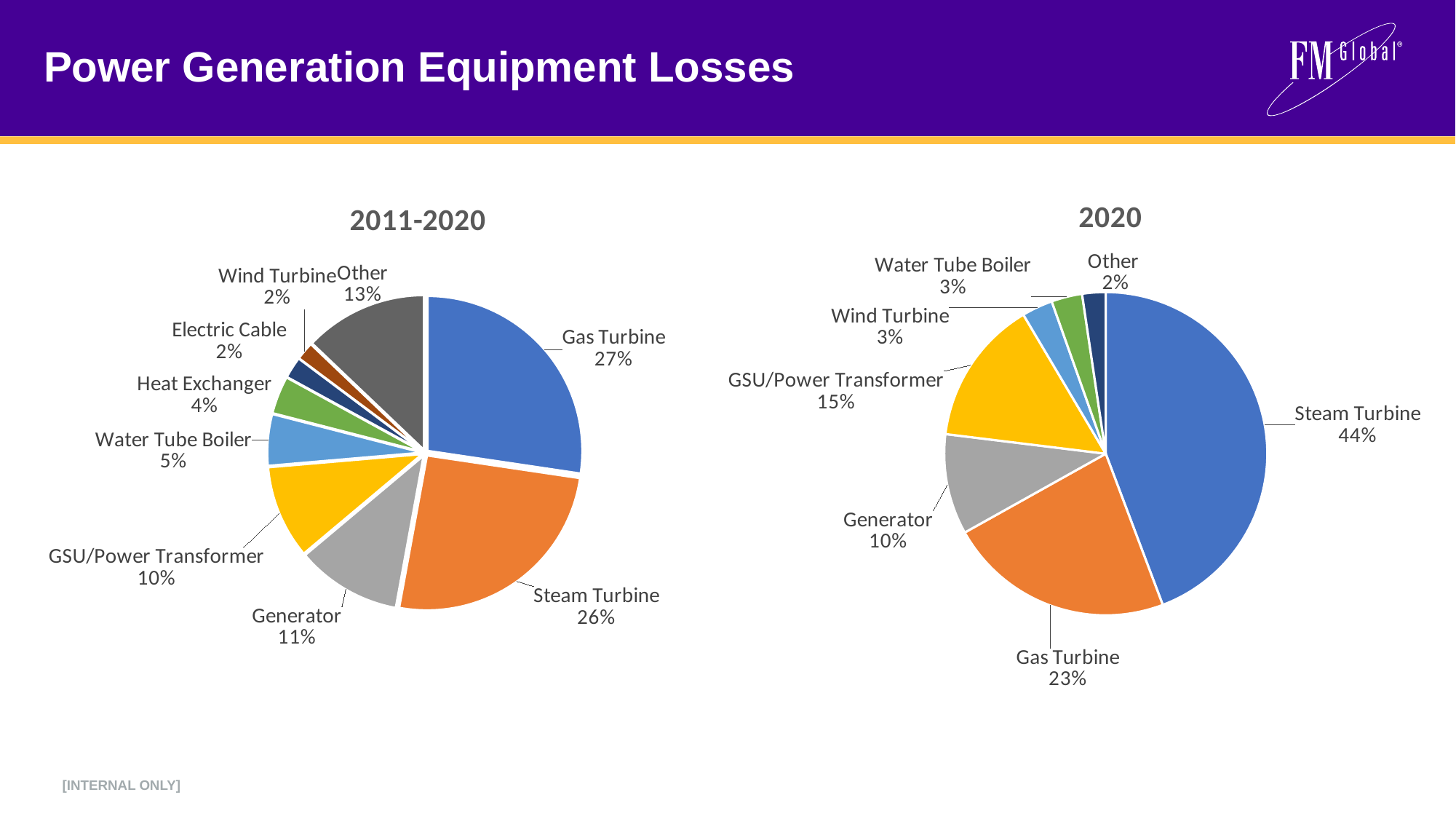
What kind of chart is the 2020 chart? Pie chart In the 2020 chart, which category has the smallest share? Other In the 2011-2020 chart, what share of losses is attributed to Gas Turbine? 27% How many categories are shown in the 2011-2020 chart? 9 How many categories are shown in the 2020 chart? 7 In the 2011-2020 chart, which is larger: the Generator share or the GSU/Power Transformer share? Generator In the 2020 chart, what is the difference between the Steam Turbine share and the Gas Turbine share? 21% In the 2011-2020 chart, what is the difference between the Other share and the Water Tube Boiler share? 8% In the 2020 chart, which category has the largest share? Steam Turbine In the 2011-2020 chart, which category has the largest share? Gas Turbine In the 2020 chart, which is larger: the GSU/Power Transformer share or the Generator share? GSU/Power Transformer In the 2020 chart, what share of losses is attributed to Steam Turbine? 44%